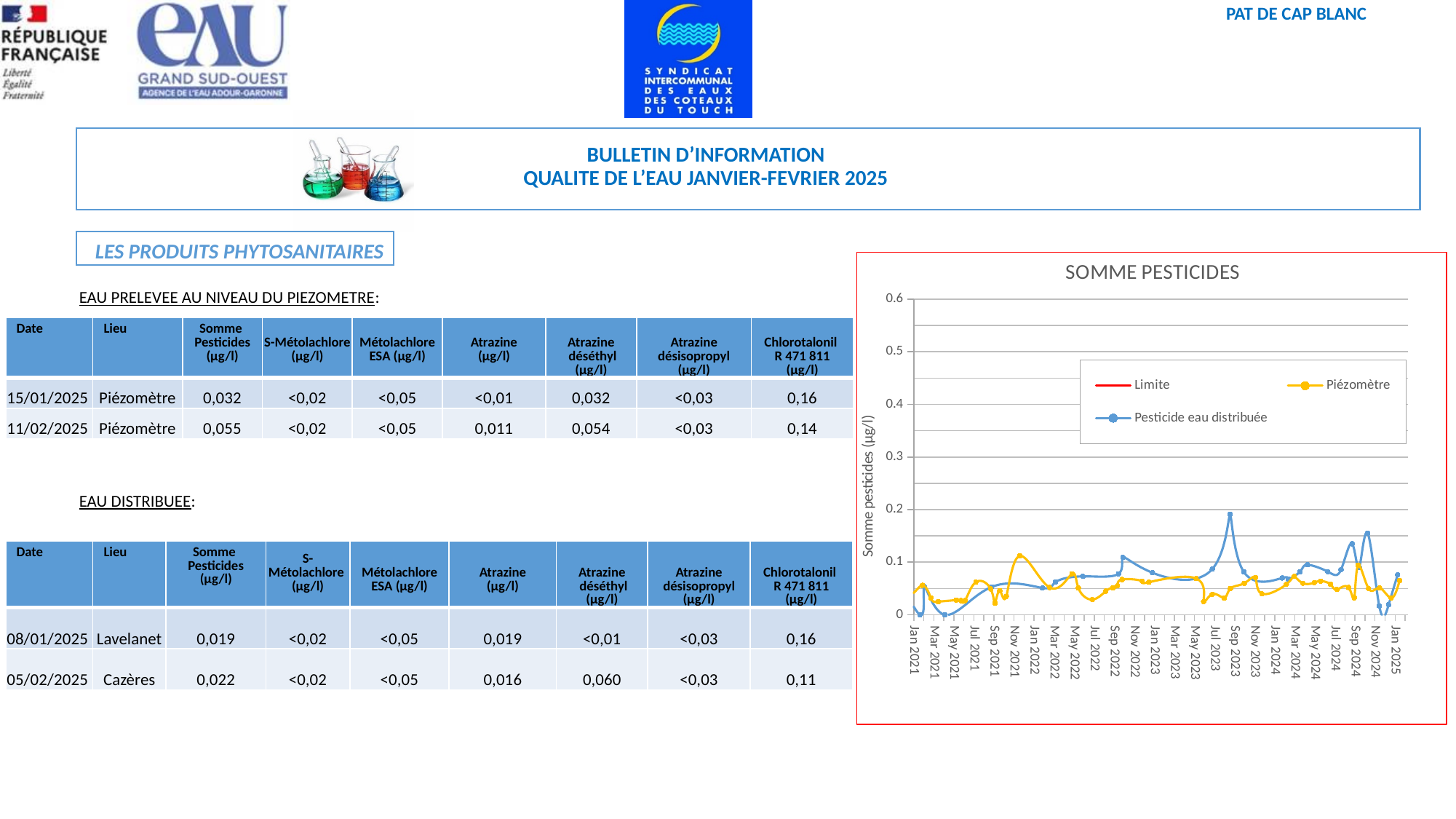
What is the label of the vertical axis of the SOMME PESTICIDES chart? Somme pesticides (µg/l) In the SOMME PESTICIDES chart, which plotted series reaches the highest value over the period? Pesticide eau distribuée What is the title of the chart on the slide? SOMME PESTICIDES What kind of chart is the SOMME PESTICIDES chart? line chart In the SOMME PESTICIDES chart, is the peak value of the Pesticide eau distribuée series around Sep 2023 greater or less than 0.1? greater How many series does the legend of the SOMME PESTICIDES chart list? 3 In the SOMME PESTICIDES chart, is the Pesticide eau distribuée value around May 2021 greater or less than 0.1? less In the SOMME PESTICIDES chart, is the Piézomètre value around Jan 2025 greater or less than 0.1? less In the SOMME PESTICIDES chart, which is larger: the peak of Pesticide eau distribuée around Sep 2023 or the peak of Piézomètre around Nov 2021? Pesticide eau distribuée around Sep 2023